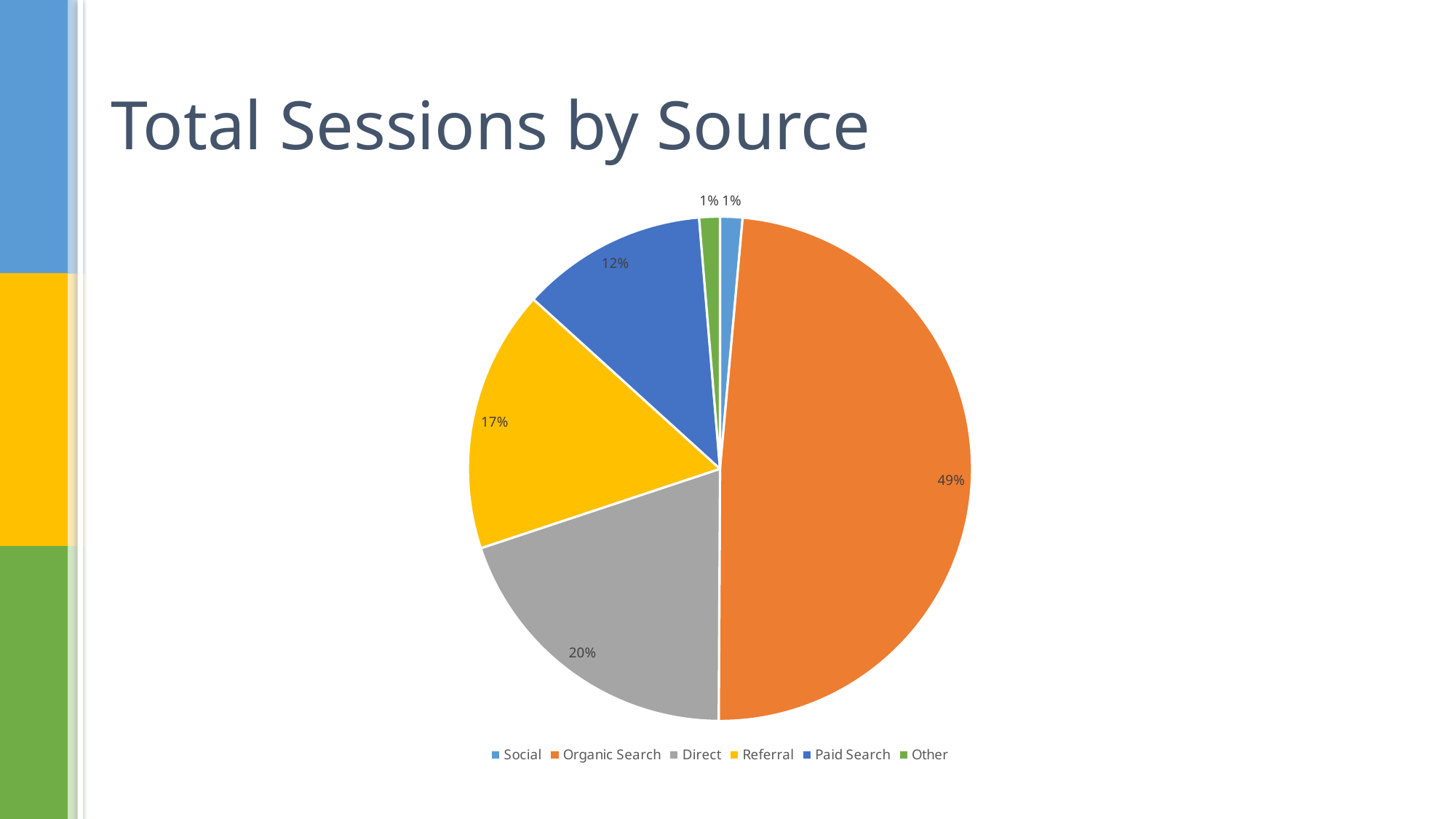
How many sources are listed in the legend? 6 What share of total sessions comes from Paid Search? 12% What share of total sessions comes from Direct? 20% Which source has the largest share of total sessions? Organic Search What share of total sessions comes from Referral? 17% What is the difference between the Organic Search share and the Direct share? 29% What is the title of the chart? Total Sessions by Source What colour is the Organic Search slice? Orange What type of chart is shown on the slide? Pie chart Which is larger, the share for Direct or the share for Referral? Direct What is the difference between the Referral share and the Paid Search share? 5%